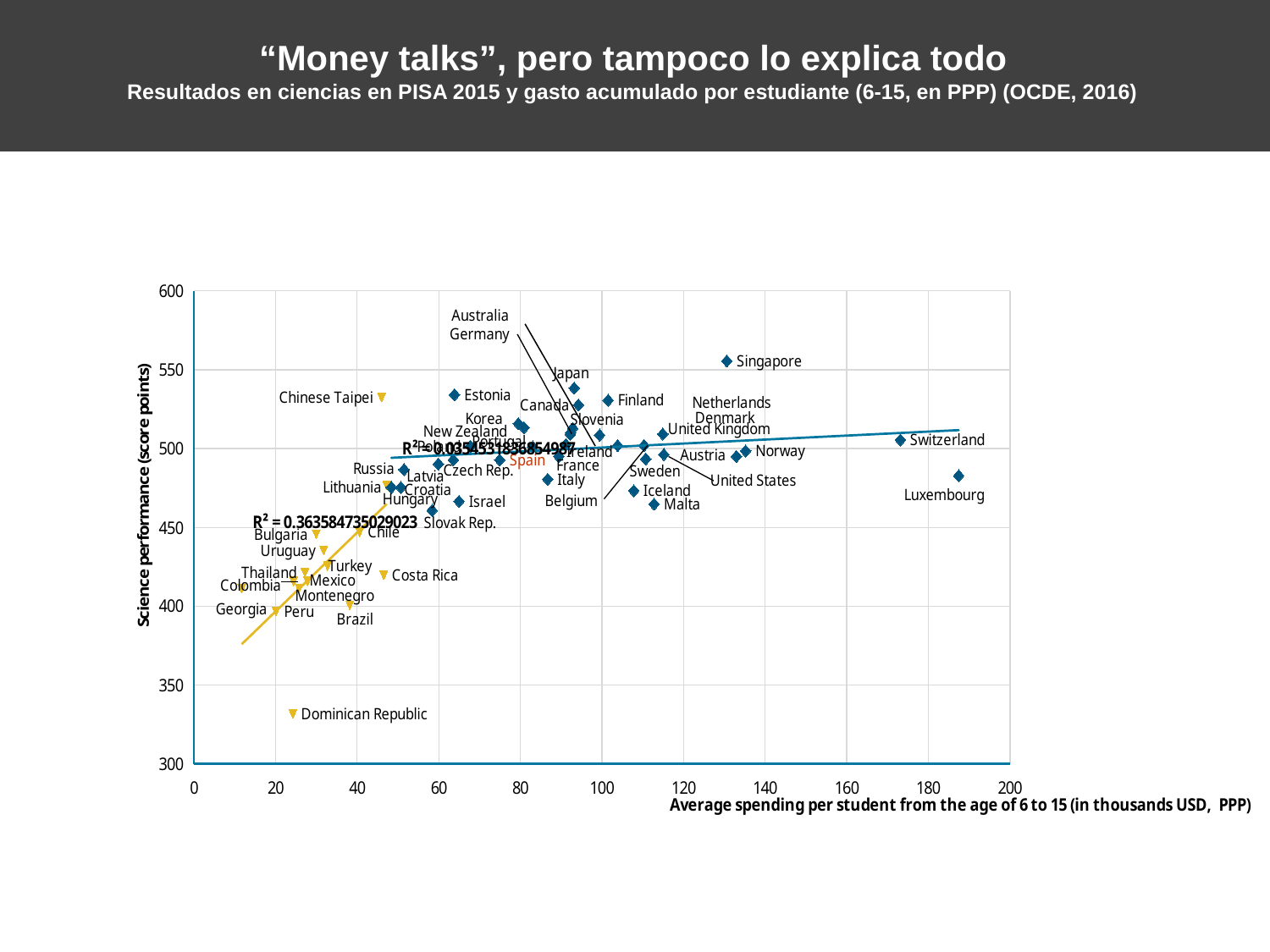
Is the science performance for Singapore greater or less than 500? greater Which has the higher science performance, Singapore or Switzerland? Singapore Is the science performance for Dominican Republic greater or less than 350? less Which country has the highest average spending per student on the chart? Luxembourg What is the label of the vertical axis? Science performance (score points) Is the science performance for Brazil greater or less than 450? less Which country has the highest science performance on the chart? Singapore What R² value is printed next to the yellow trend line? R² = 0.363584735029023 Which country has the lowest science performance on the chart? Dominican Republic What kind of chart is shown on the slide? scatter chart Which has the higher average spending per student, Luxembourg or Switzerland? Luxembourg